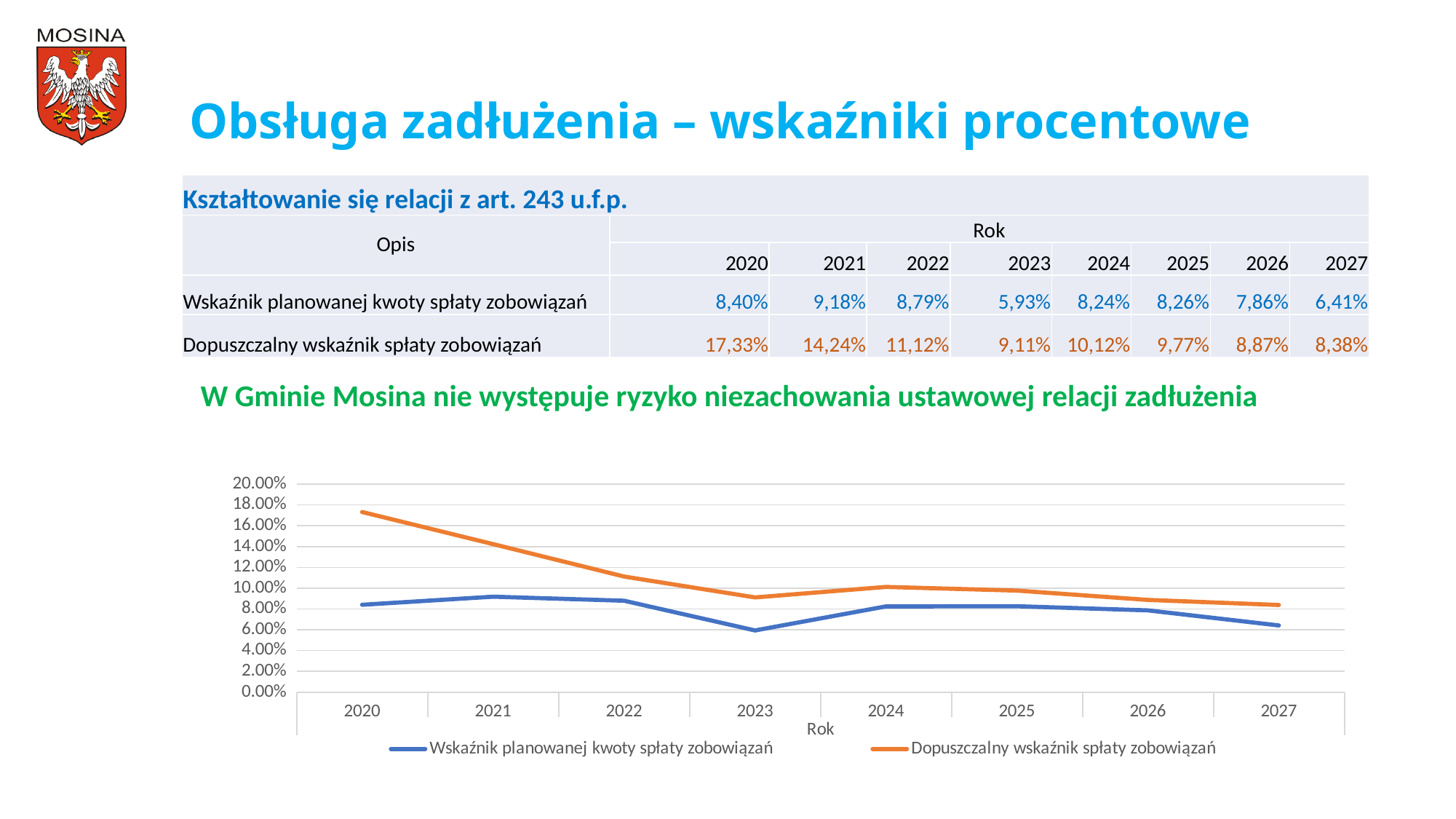
In which year is Wskaźnik planowanej kwoty spłaty zobowiązań highest? 2021 Which series has the larger value in 2024, Wskaźnik planowanej kwoty spłaty zobowiązań or Dopuszczalny wskaźnik spłaty zobowiązań? Dopuszczalny wskaźnik spłaty zobowiązań How many years are shown on the x axis of the chart? 8 Is the value of Dopuszczalny wskaźnik spłaty zobowiązań for 2022 greater or less than 10.00%? greater In which year is Wskaźnik planowanej kwoty spłaty zobowiązań lowest? 2023 How many series does the chart legend list? 2 What is the difference between Dopuszczalny wskaźnik spłaty zobowiązań and Wskaźnik planowanej kwoty spłaty zobowiązań in 2020? 8,93% What is the value of Wskaźnik planowanej kwoty spłaty zobowiązań for 2023? 5,93% In which year is Dopuszczalny wskaźnik spłaty zobowiązań lowest? 2027 What type of chart is shown at the bottom of the slide? line chart What is the value of Dopuszczalny wskaźnik spłaty zobowiązań for 2020? 17,33% Does the Dopuszczalny wskaźnik spłaty zobowiązań line rise or fall from 2020 to 2023? fall